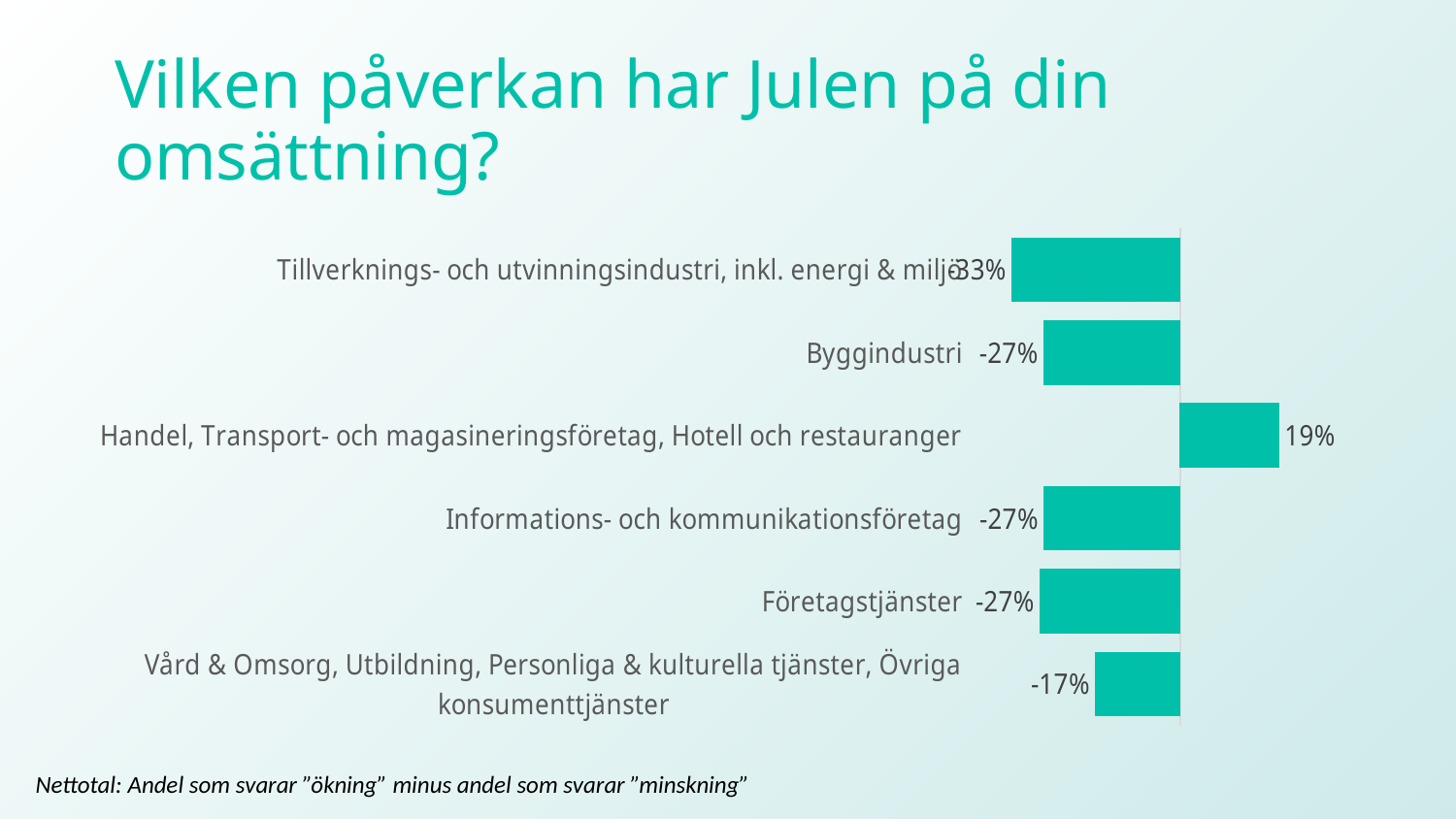
What is the title of the chart on the slide? Vilken påverkan har Julen på din omsättning? What is the value for Byggindustri? -27% What is the value for Informations- och kommunikationsföretag? -27% What is the value for Handel, Transport- och magasineringsföretag, Hotell och restauranger? 19% Which category has the lowest value? Tillverknings- och utvinningsindustri, inkl. energi & miljö What is the difference between the value for Handel, Transport- och magasineringsföretag, Hotell och restauranger and the value for Företagstjänster? 46 percentage points What type of chart is shown on the slide? bar chart What is the value for Vård & Omsorg, Utbildning, Personliga & kulturella tjänster, Övriga konsumenttjänster? -17% Which is larger, the value for Byggindustri or the value for Vård & Omsorg, Utbildning, Personliga & kulturella tjänster, Övriga konsumenttjänster? Vård & Omsorg, Utbildning, Personliga & kulturella tjänster, Övriga konsumenttjänster What is the value for Företagstjänster? -27% Which category has the highest value? Handel, Transport- och magasineringsföretag, Hotell och restauranger How many categories are shown in the chart? 6